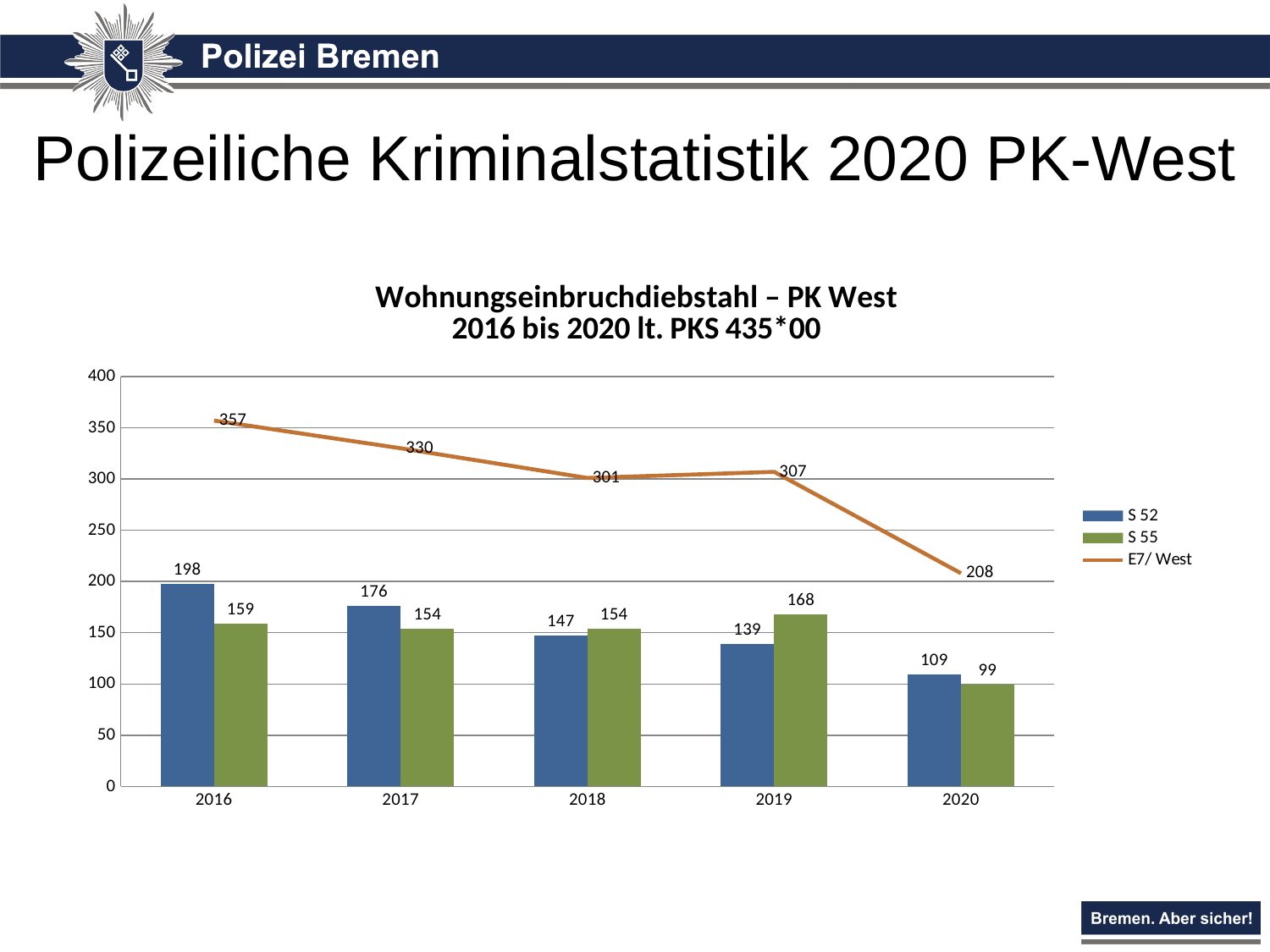
Is the value for S 52 in 2017 greater or less than 150? greater What is the title of the chart? Wohnungseinbruchdiebstahl – PK West 2016 bis 2020 lt. PKS 435*00 Does the S 52 series rise or fall from 2016 to 2020? fall What is the value for S 55 in 2019? 168 How many years are shown on the x axis? 5 What is the difference between the E7/ West values for 2019 and 2020? 99 What is the value for S 52 in 2016? 198 In which year is the E7/ West line highest? 2016 In which year is the S 55 value lowest? 2020 Which is larger in 2018, S 52 or S 55? S 55 What is the value for E7/ West in 2020? 208 How many series does the legend list? 3